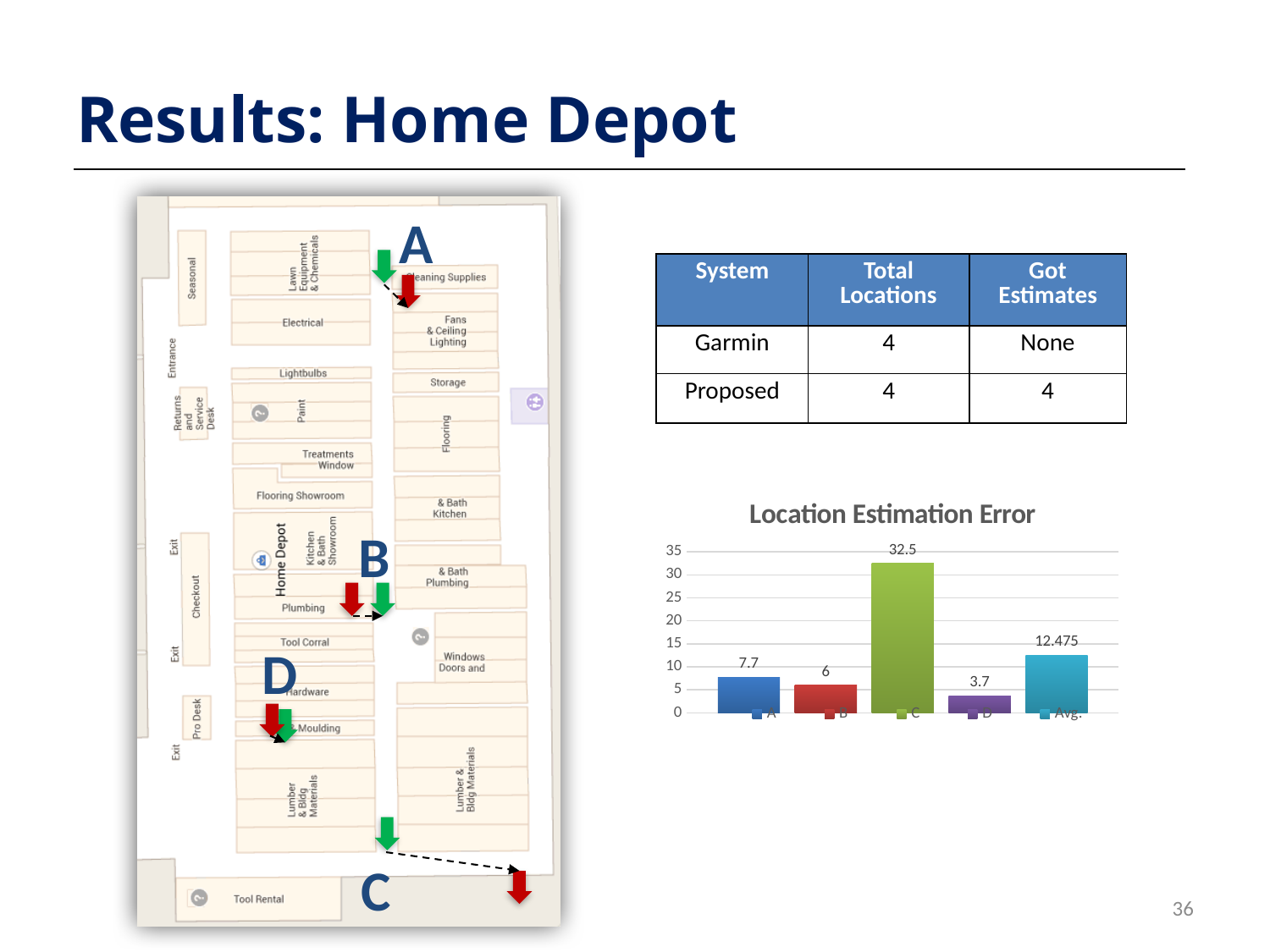
In the Location Estimation Error chart, what is the value for A? 7.7 In the Location Estimation Error chart, what is the difference between the values for C and D? 28.8 What is the title of the chart on the slide? Location Estimation Error In the Location Estimation Error chart, what is the value for Avg.? 12.475 What kind of chart is the Location Estimation Error chart? bar chart In the Location Estimation Error chart, which is larger, the value for A or the value for B? A In the Location Estimation Error chart, what is the value for C? 32.5 In the Location Estimation Error chart, which category has the highest value? C In the Location Estimation Error chart, is the value for C greater or less than 30? greater In the Location Estimation Error chart, what is the difference between the values for A and B? 1.7 In the Location Estimation Error chart, which category has the lowest value? D How many bars are plotted in the Location Estimation Error chart? 5